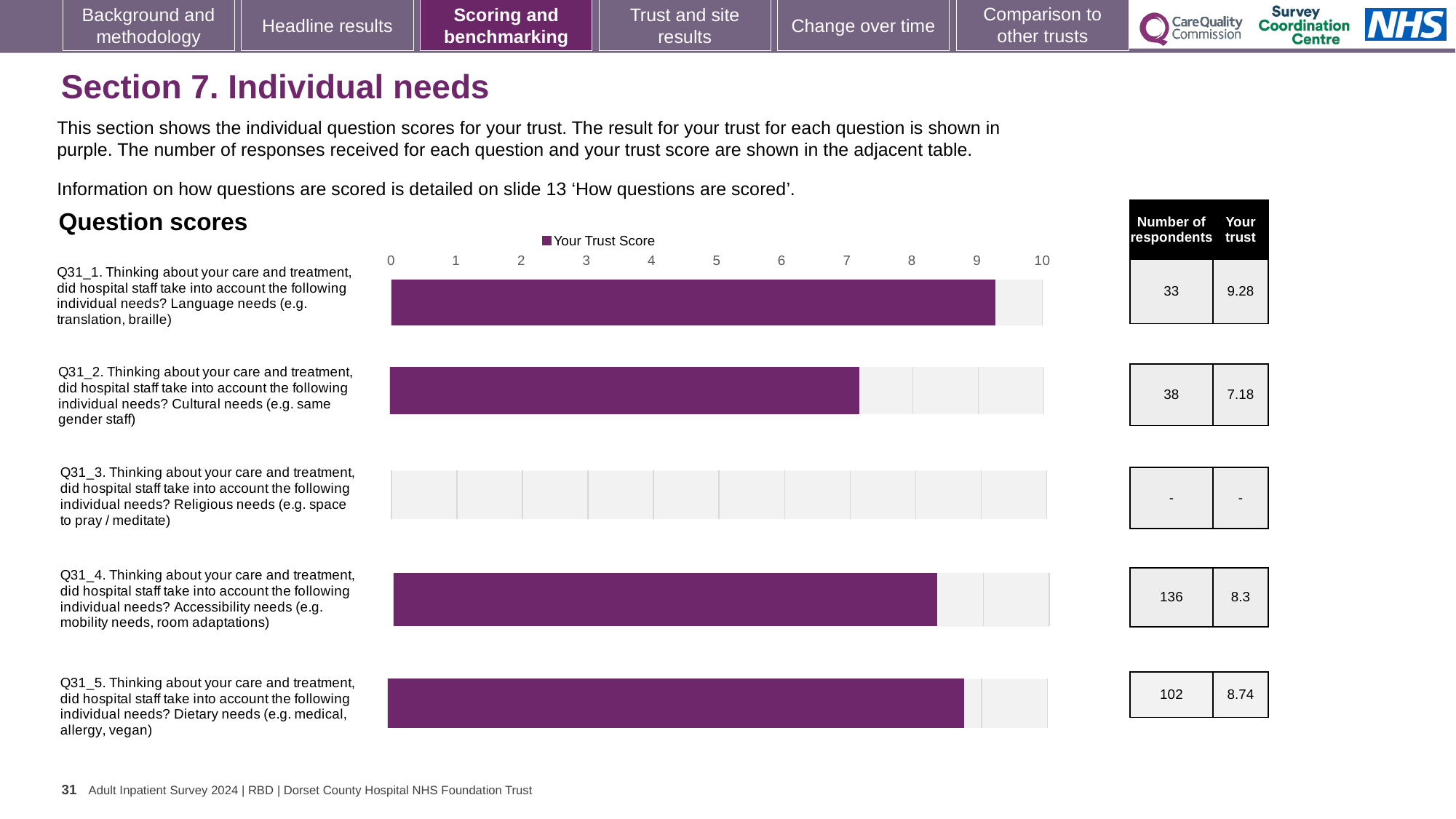
What is the difference between the trust scores for Q31_1 and Q31_2? 2.1 What is the trust score for Q31_1 (Language needs)? 9.28 How many questions are listed in the chart? 5 Is the trust score for Q31_2 (Cultural needs) greater or less than 8? less Among the questions with a plotted score, which has the lowest trust score? Q31_2 (Cultural needs) Which has a higher trust score, Q31_4 (Accessibility needs) or Q31_5 (Dietary needs)? Q31_5 (Dietary needs) What is the name of the series shown in the chart legend? Your Trust Score What is the trust score for Q31_4 (Accessibility needs)? 8.3 Which question has the highest trust score? Q31_1 (Language needs) What type of chart is used to show the question scores? Bar chart What is the trust score for Q31_2 (Cultural needs)? 7.18 What is the trust score for Q31_5 (Dietary needs)? 8.74